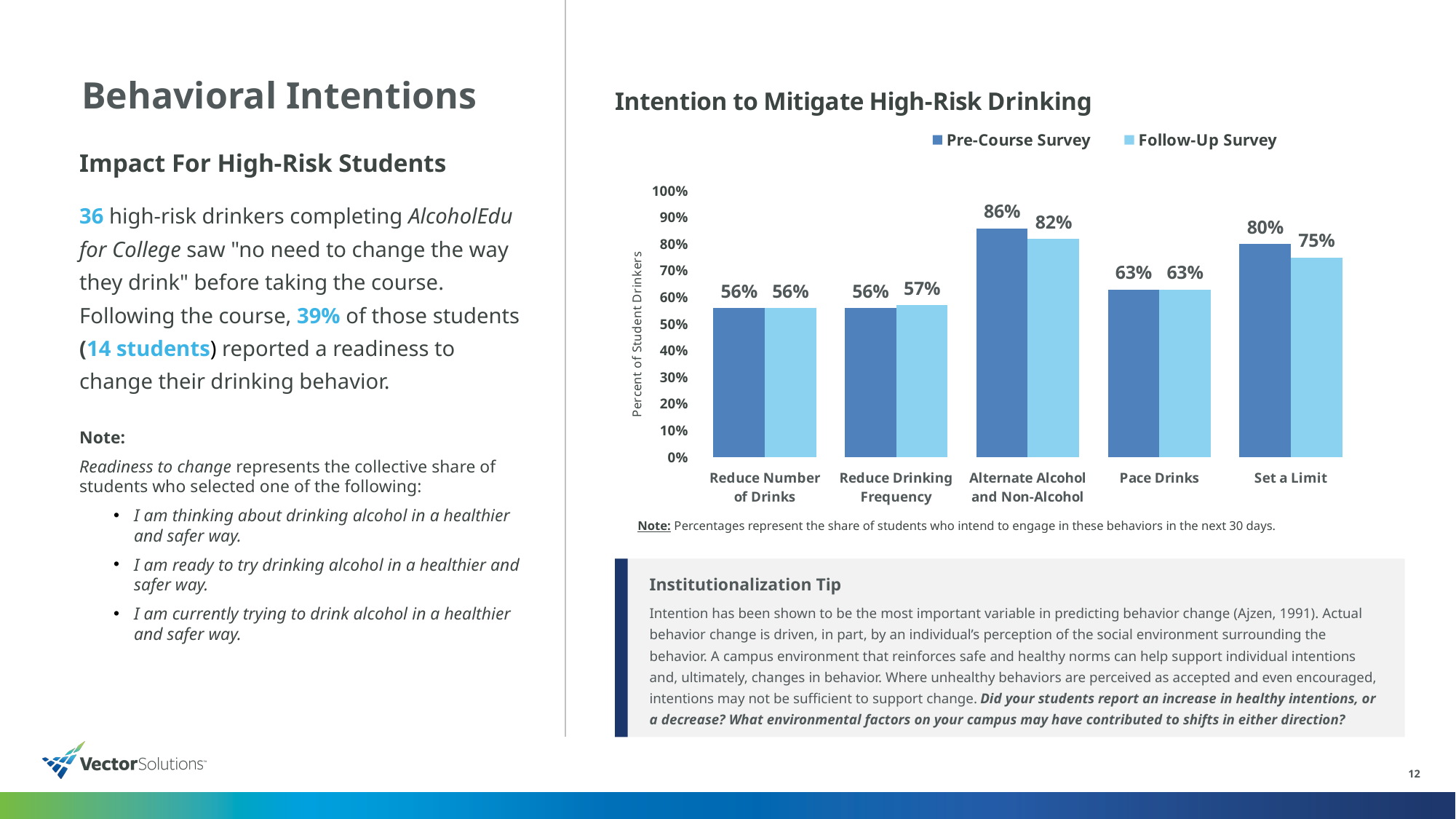
What is the difference between the Pre-Course Survey and Follow-Up Survey values for Set a Limit? 5% What is the label on the vertical axis of the chart? Percent of Student Drinkers Which category has the lowest Follow-Up Survey value? Reduce Number of Drinks What is the Pre-Course Survey value for Alternate Alcohol and Non-Alcohol? 86% Which is larger for Alternate Alcohol and Non-Alcohol: the Pre-Course Survey value or the Follow-Up Survey value? Pre-Course Survey How many series does the legend list? 2 What is the title of the chart? Intention to Mitigate High-Risk Drinking What kind of chart is shown on the slide? Bar chart Which category has the highest Pre-Course Survey value? Alternate Alcohol and Non-Alcohol What is the Follow-Up Survey value for Reduce Drinking Frequency? 57% How many categories are shown on the x axis of the chart? 5 What is the Follow-Up Survey value for Set a Limit? 75%